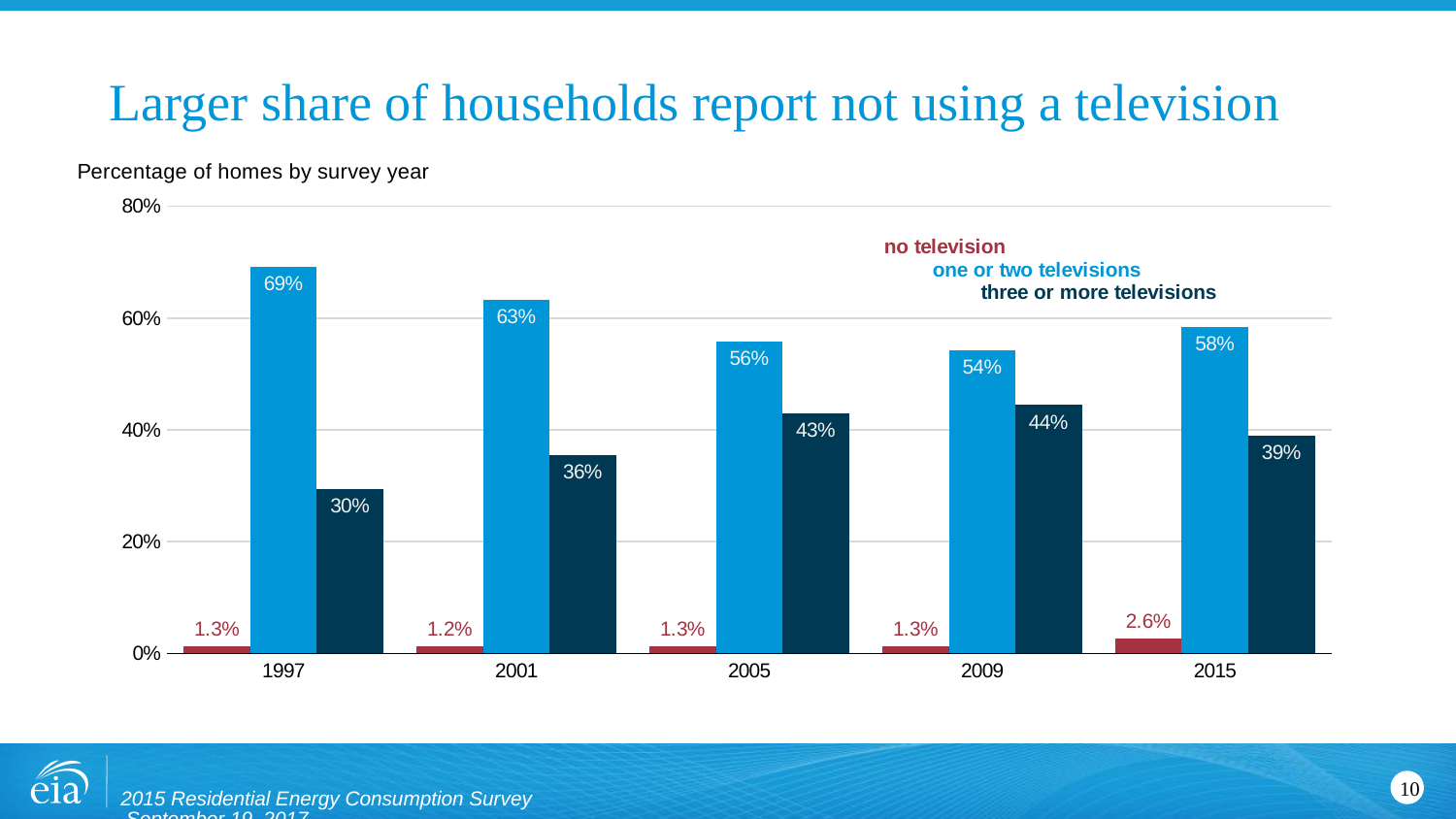
What is the difference between the share of homes with one or two televisions and the share with three or more televisions in 2005? 13% How many series does the chart show? 3 Is the share of homes with three or more televisions in 2001 greater or less than 40%? less What percentage of homes had one or two televisions in 1997? 69% How many survey years are shown on the x axis? 5 What percentage of homes had three or more televisions in 2009? 44% Which was larger in 2015: the share of homes with one or two televisions or the share with three or more televisions? one or two televisions In which survey year was the share of homes with three or more televisions lowest? 1997 What kind of chart is shown on the slide? bar chart Does the share of homes with one or two televisions rise or fall from 1997 to 2009? fall What percentage of homes reported no television in 2015? 2.6% In which survey year was the share of homes with one or two televisions highest? 1997